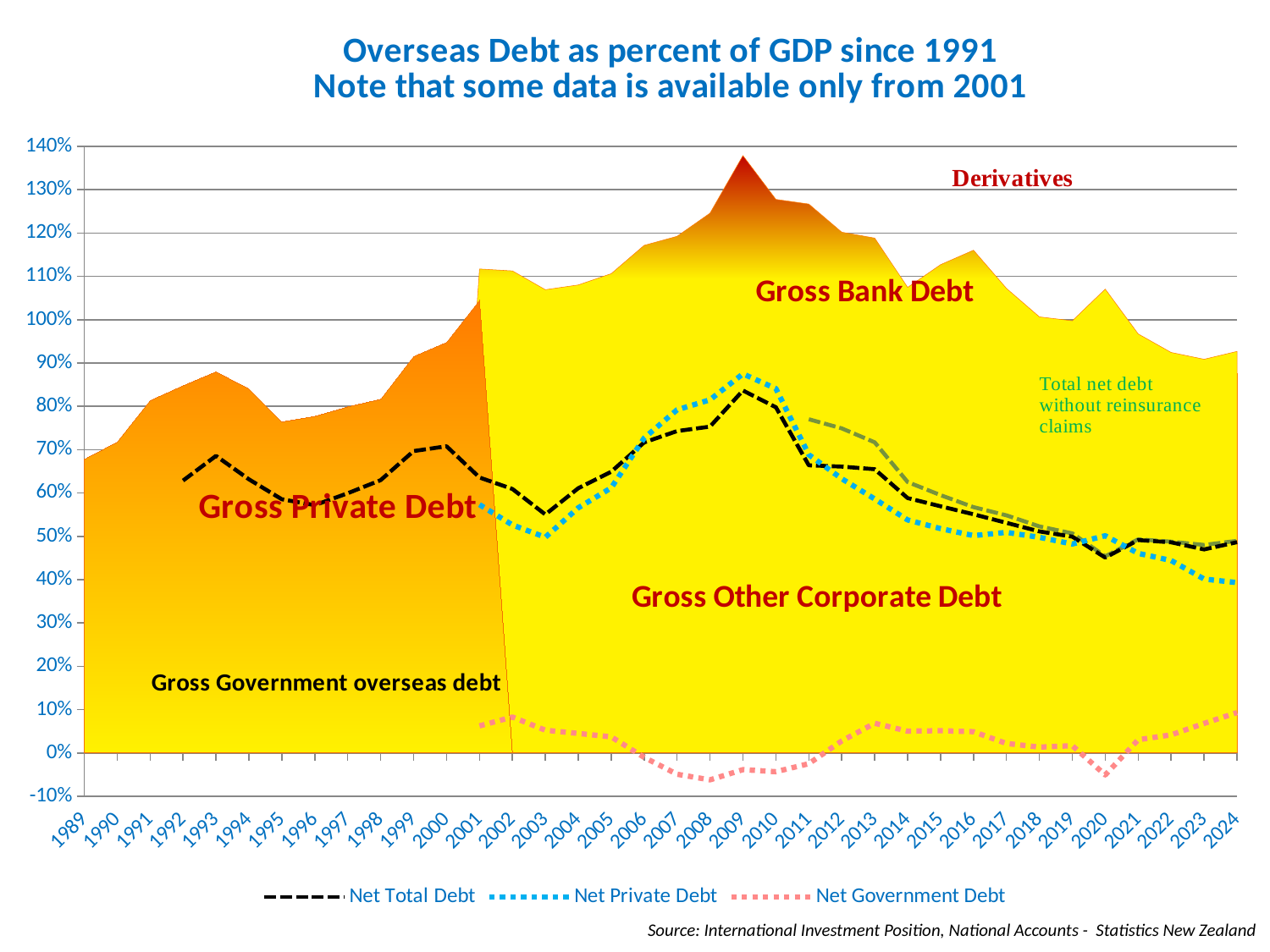
How many series does the legend list? 3 In which year does Net Total Debt reach its highest value? 2009 Is the value of Net Total Debt in 2020 greater or less than 50%? less Is the top of the stacked area in 2009 greater or less than 130%? greater Is the value of Net Total Debt in 2009 greater or less than 80%? greater Which series does the legend list? Net Total Debt, Net Private Debt, Net Government Debt Which is larger, Net Total Debt in 2009 or Net Total Debt in 2003? 2009 In which year does Net Private Debt reach its highest value? 2009 What kind of chart is shown on the slide? Stacked area chart with line series Does Net Private Debt rise or fall from 2009 to 2024? fall How many years are shown on the x axis? 36